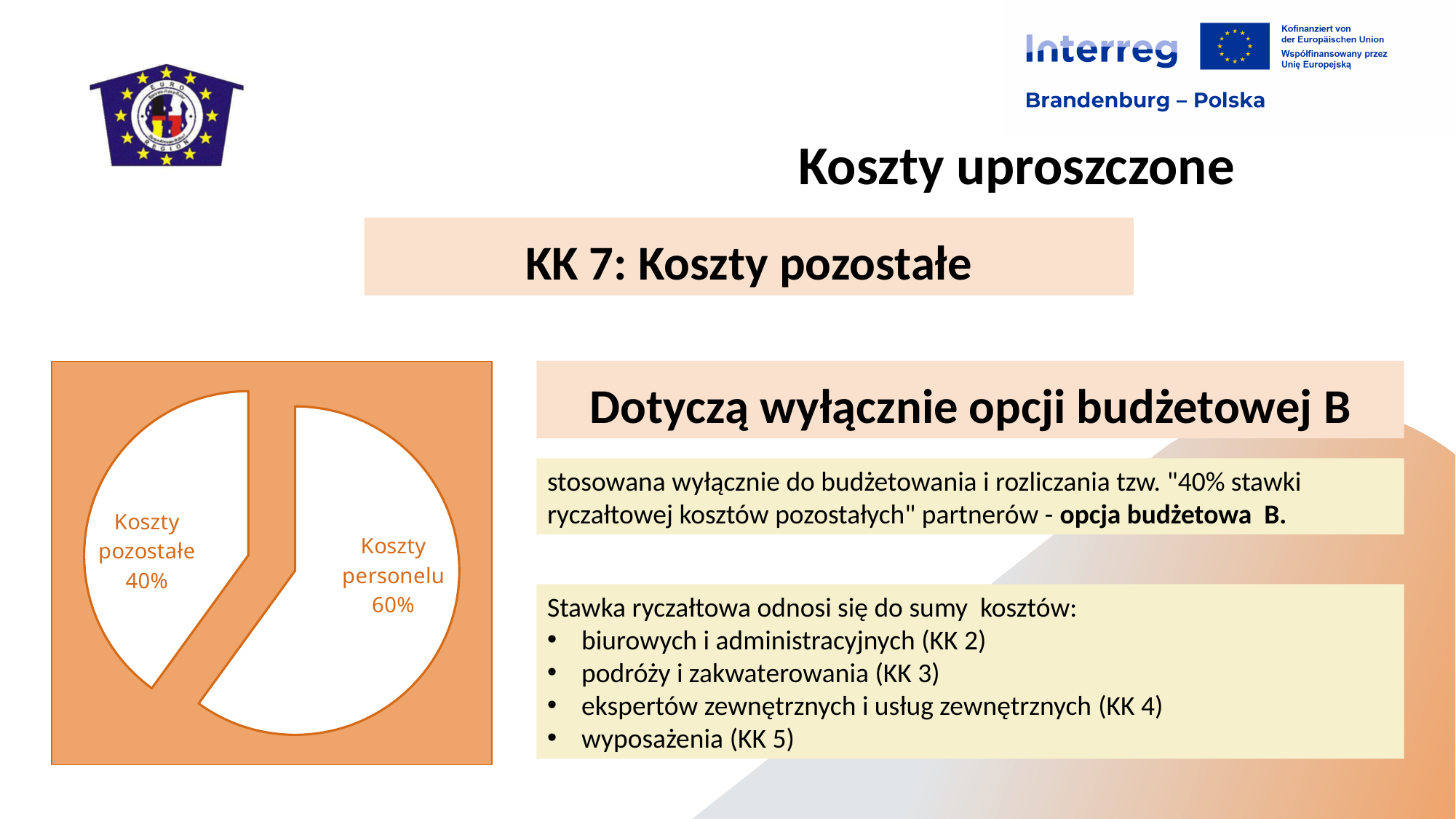
Is the share for Koszty pozostałe greater or less than 50%? less What is the difference in percentage points between Koszty personelu and Koszty pozostałe? 20% What share of the pie is labelled Koszty pozostałe? 40% Is one slice of the pie chart pulled out (exploded) from the rest? yes What share of the pie is labelled Koszty personelu? 60% Which slice of the pie is the smallest? Koszty pozostałe What colour is the background of the pie chart box? orange How many slices does the pie chart have? 2 What is the total of the two slices shown in the pie chart? 100% What kind of chart is shown on the slide? pie chart Which is larger, Koszty pozostałe or Koszty personelu? Koszty personelu Which slice of the pie is the largest? Koszty personelu